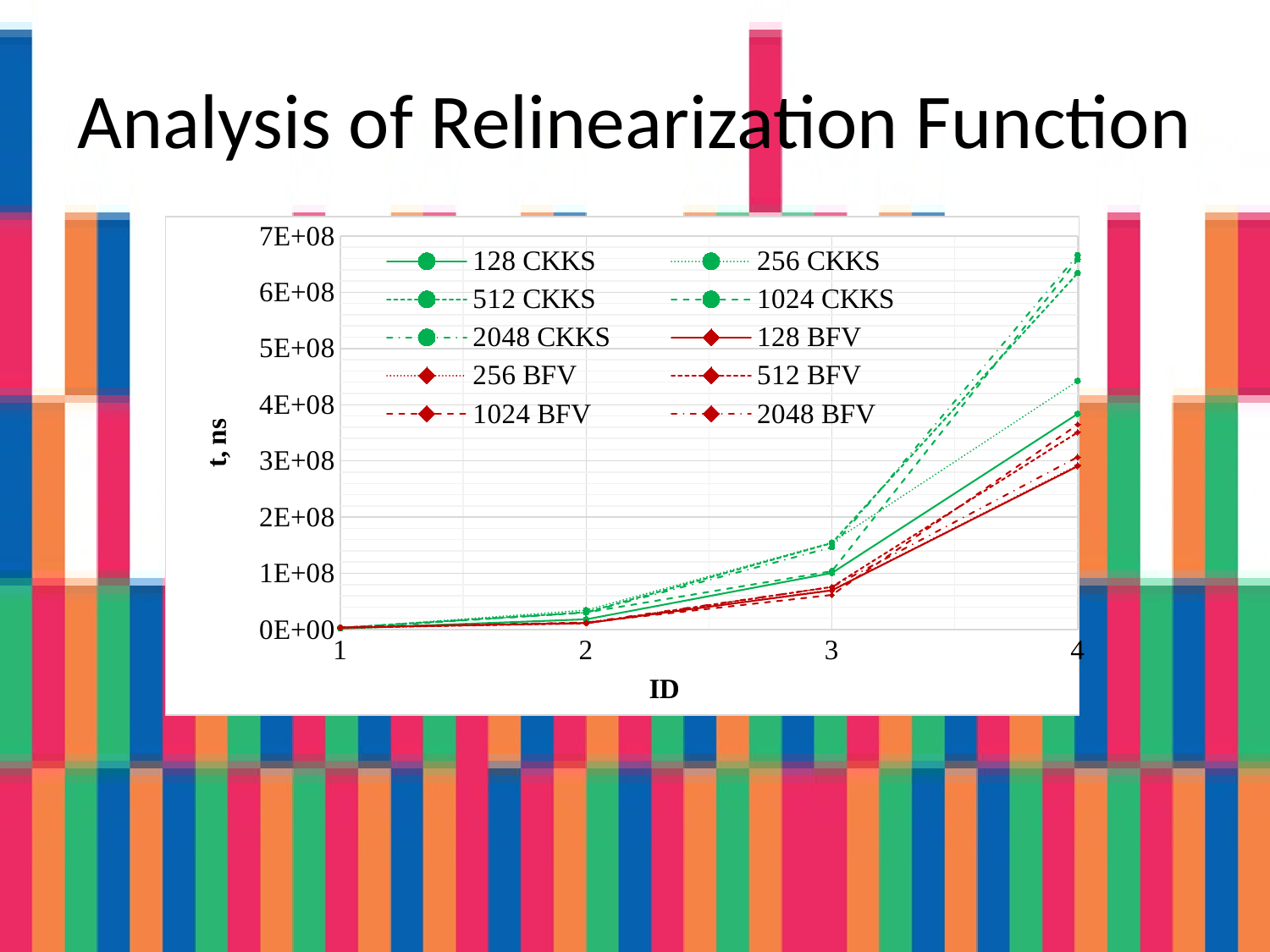
How many series does the legend list? 10 At which ID is the value for 512 CKKS lowest? 1 What is the label of the y axis? t, ns Is the value for 128 BFV at ID 4 greater or less than 4E+08? less At ID 4, which is larger: the value for 512 CKKS or the value for 128 BFV? 512 CKKS What kind of chart is shown on the slide? line chart Is the value for 512 CKKS at ID 4 greater or less than 5E+08? greater At which ID does 128 BFV reach its highest value? 4 Is the value for 256 CKKS at ID 3 greater or less than 2E+08? less Do the values for 128 CKKS rise or fall as ID increases from 1 to 4? rise What is the label of the x axis? ID How many ID values are plotted along the x axis? 4